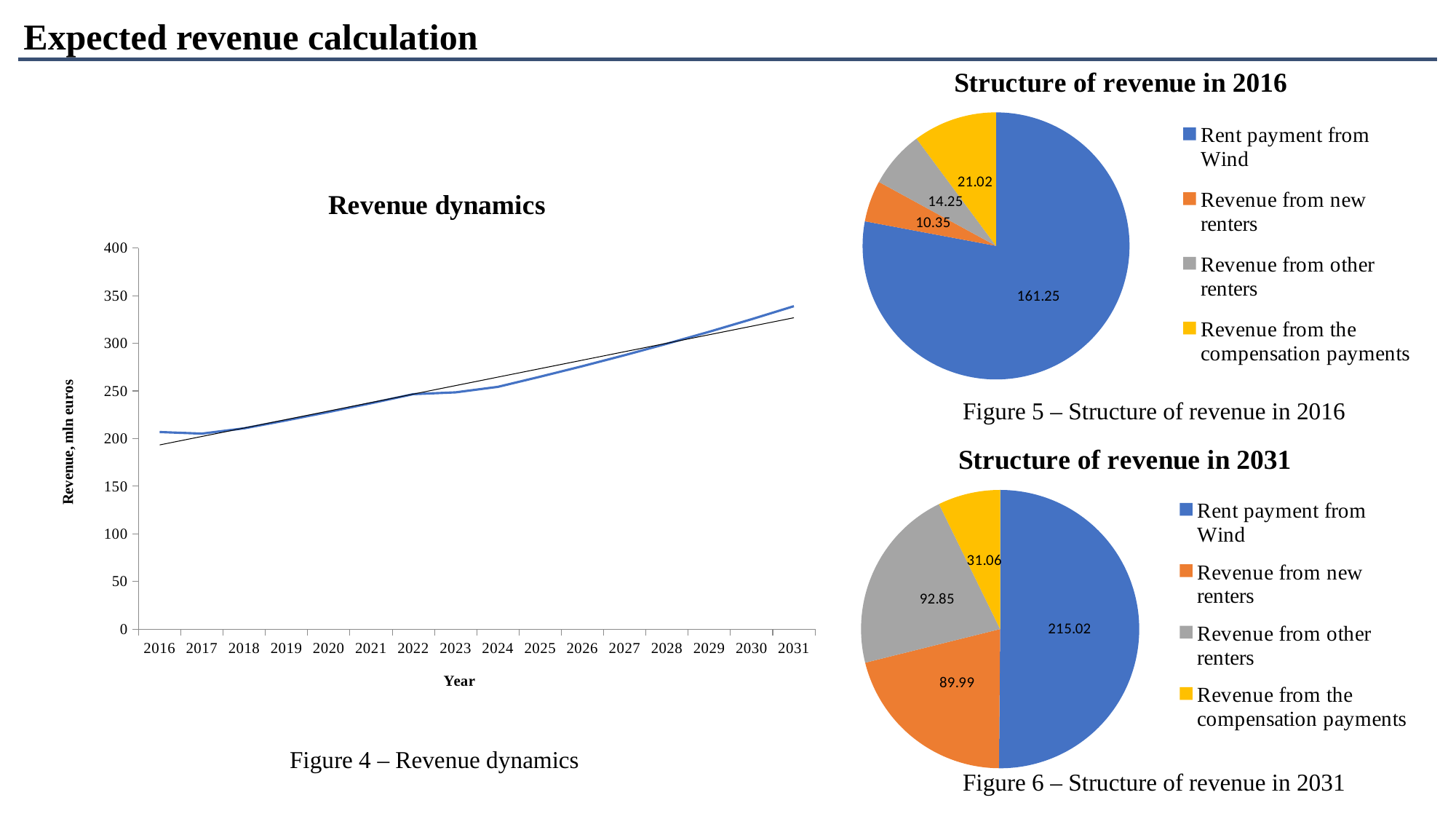
In the Structure of revenue in 2016 chart, which category has the largest value? Rent payment from Wind In the Structure of revenue in 2031 chart, which category has the smallest value? Revenue from the compensation payments In the Revenue dynamics chart, is the value for 2031 greater or less than 300? greater In the Revenue dynamics chart, is the value for 2020 greater or less than 250? less In the Structure of revenue in 2016 chart, what is the value for Rent payment from Wind? 161.25 How many years are shown on the x axis of the Revenue dynamics chart? 16 In the Structure of revenue in 2016 chart, what is the value for Revenue from the compensation payments? 21.02 In the Structure of revenue in 2031 chart, what is the value for Revenue from other renters? 92.85 In the Structure of revenue in 2031 chart, what is the difference between Rent payment from Wind and Revenue from new renters? 125.03 In the Revenue dynamics chart, do the values rise or fall from 2016 to 2031? rise What kind of chart is the Structure of revenue in 2031 chart? pie chart In the Structure of revenue in 2016 chart, which is larger: Revenue from other renters or Revenue from new renters? Revenue from other renters